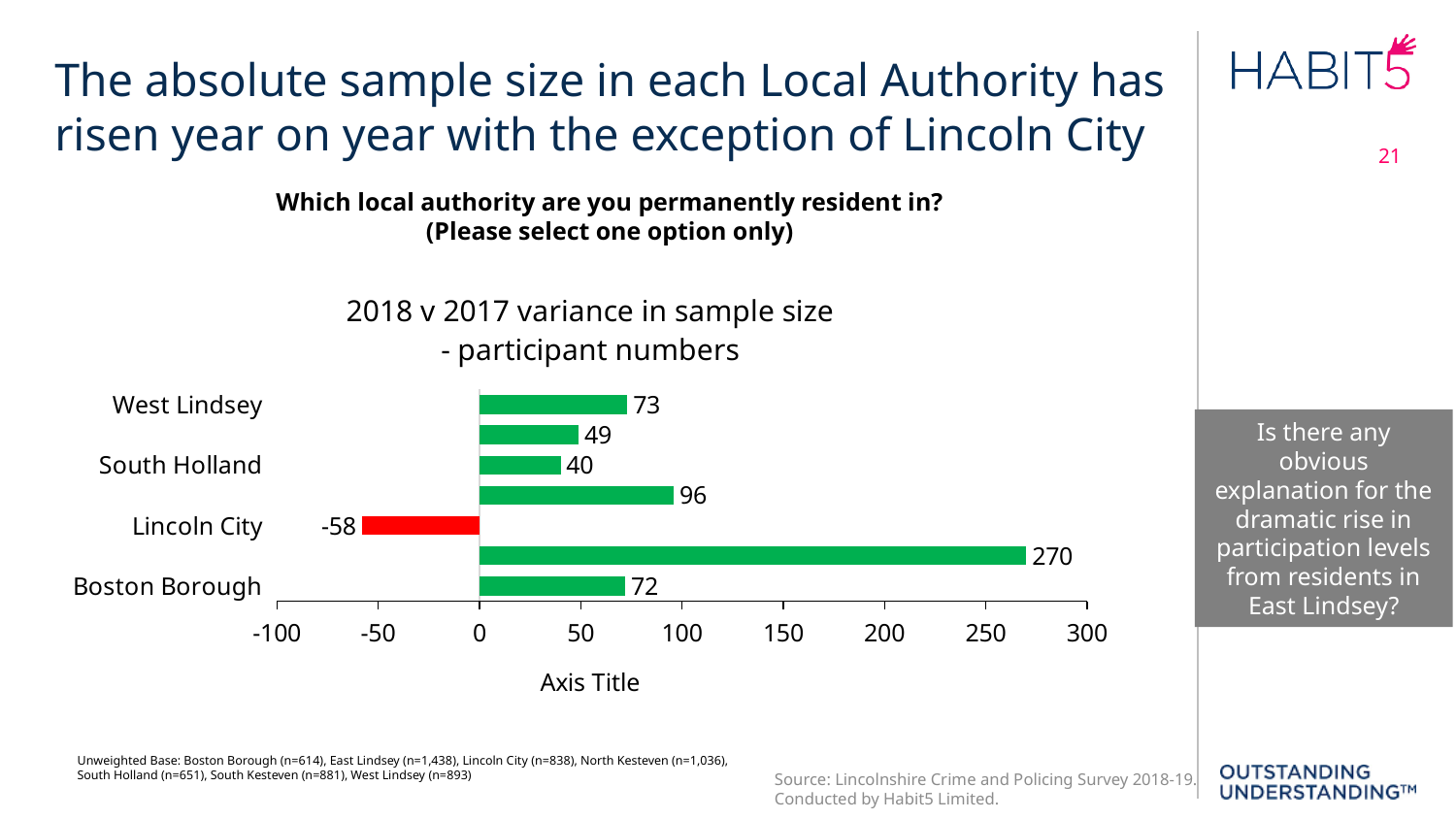
What is the value for South Holland in the chart? 40 What kind of chart is shown on the slide? Bar chart Which is larger, the value for West Lindsey or the value for Boston Borough? West Lindsey What colour is the bar for Lincoln City? Red What is the title of the chart? 2018 v 2017 variance in sample size - participant numbers What is the value for Lincoln City in the chart? -58 Which labelled local authority has the lowest value in the chart? Lincoln City What is the value for Boston Borough in the chart? 72 What is the largest value shown on any bar in the chart? 270 What is the difference between the values for West Lindsey and South Holland? 33 How many bars are plotted in the chart? 7 What is the value for West Lindsey in the chart? 73